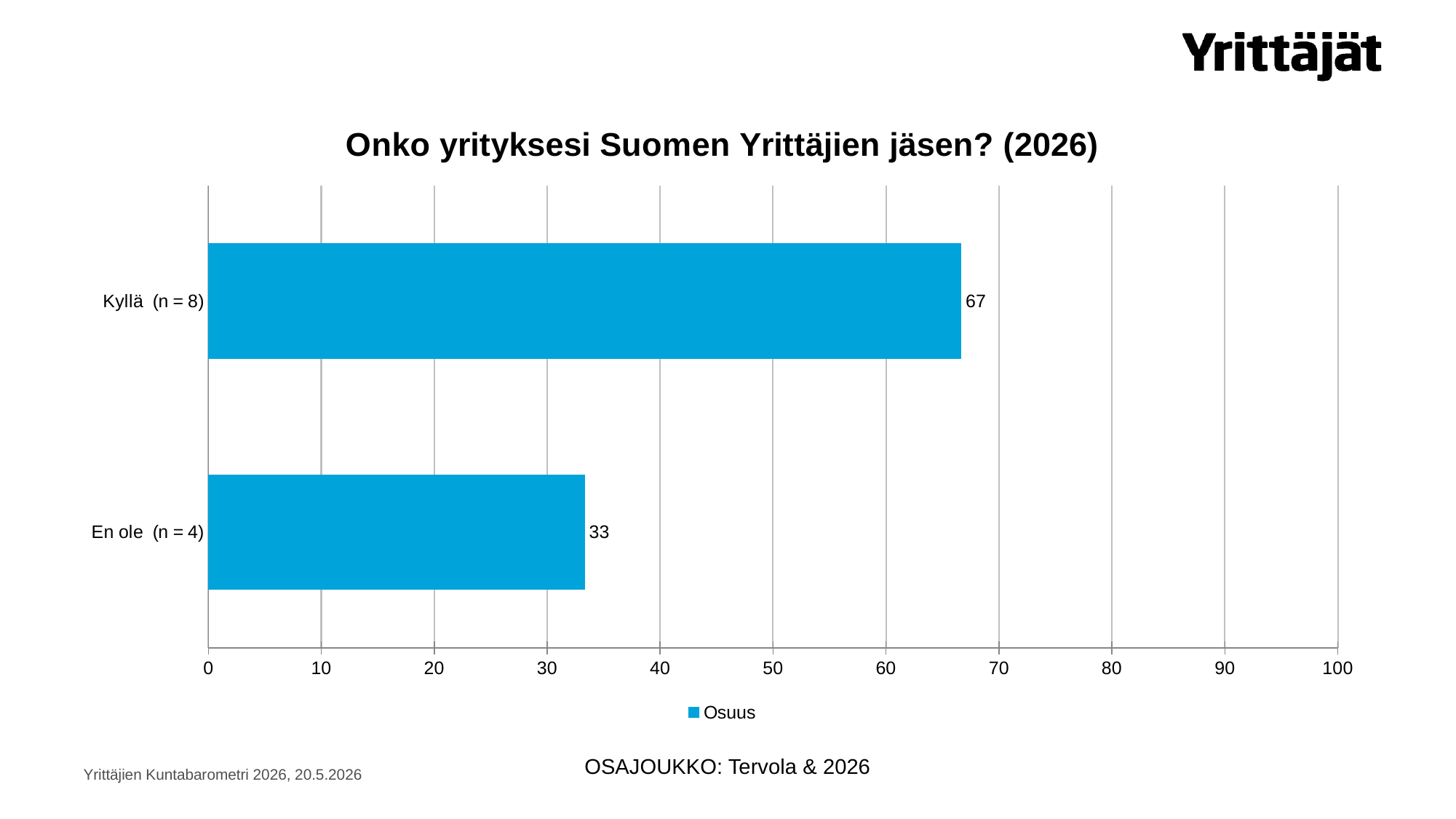
What is the value for Kyllä (n = 8)? 67 What is the title of the chart? Onko yrityksesi Suomen Yrittäjien jäsen? (2026) What kind of chart is shown on the slide? bar chart What is the difference between the values for Kyllä (n = 8) and En ole (n = 4)? 34 Which is larger, the value for Kyllä (n = 8) or the value for En ole (n = 4)? Kyllä (n = 8) What is the value for En ole (n = 4)? 33 Is the value for Kyllä (n = 8) greater or less than 60? greater How many categories are shown in the chart? 2 How many series does the legend list? 1 Is the value for En ole (n = 4) greater or less than 40? less Which category has the highest value? Kyllä (n = 8) Which category has the lowest value? En ole (n = 4)